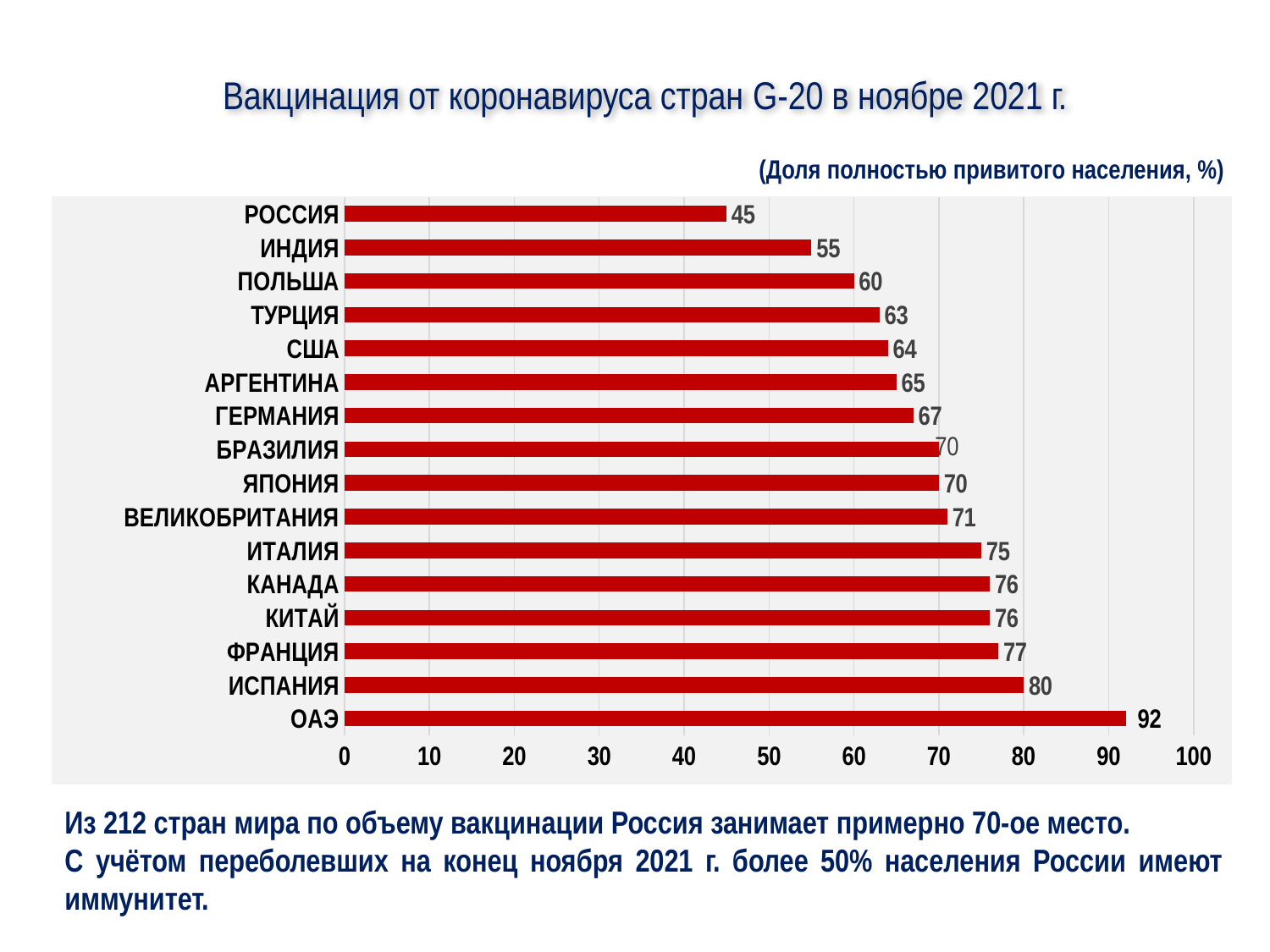
What is the value for ОАЭ? 92 What is the difference between the values for ОАЭ and РОССИЯ? 47 Is the value for ПОЛЬША greater or less than 50? greater How many countries are shown in the chart? 16 Which is larger, the value for ФРАНЦИЯ or the value for ИТАЛИЯ? ФРАНЦИЯ What is the difference between the values for ИСПАНИЯ and ИНДИЯ? 25 What is the value for ГЕРМАНИЯ? 67 Which country has the highest value? ОАЭ What kind of chart is shown on the slide? bar chart Which country has the lowest value? РОССИЯ What is the title of the chart? Вакцинация от коронавируса стран G-20 в ноябре 2021 г. What is the value for РОССИЯ? 45